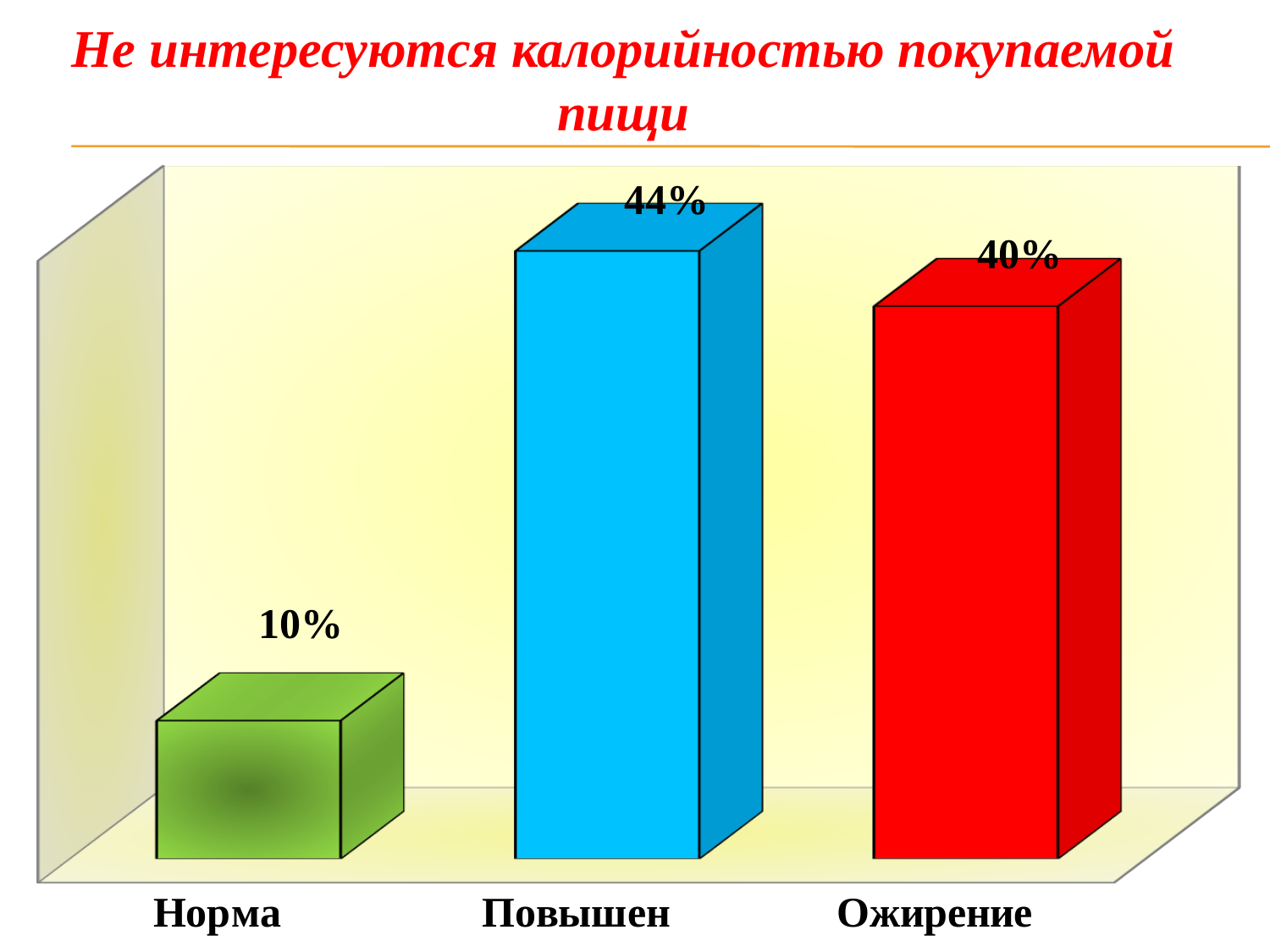
What is the difference between the values for Ожирение and Норма? 30% What kind of chart is shown on the slide? bar chart Which is larger, the value for Норма or the value for Ожирение? Ожирение What is the value for Повышен? 44% What is the difference between the values for Повышен and Ожирение? 4% Which category has the lowest value? Норма Which category has the highest value? Повышен What is the title of the chart? Не интересуются калорийностью покупаемой пищи What is the value for Ожирение? 40% How many categories are shown in the chart? 3 What is the value for Норма? 10% What colour is the bar for Повышен? blue